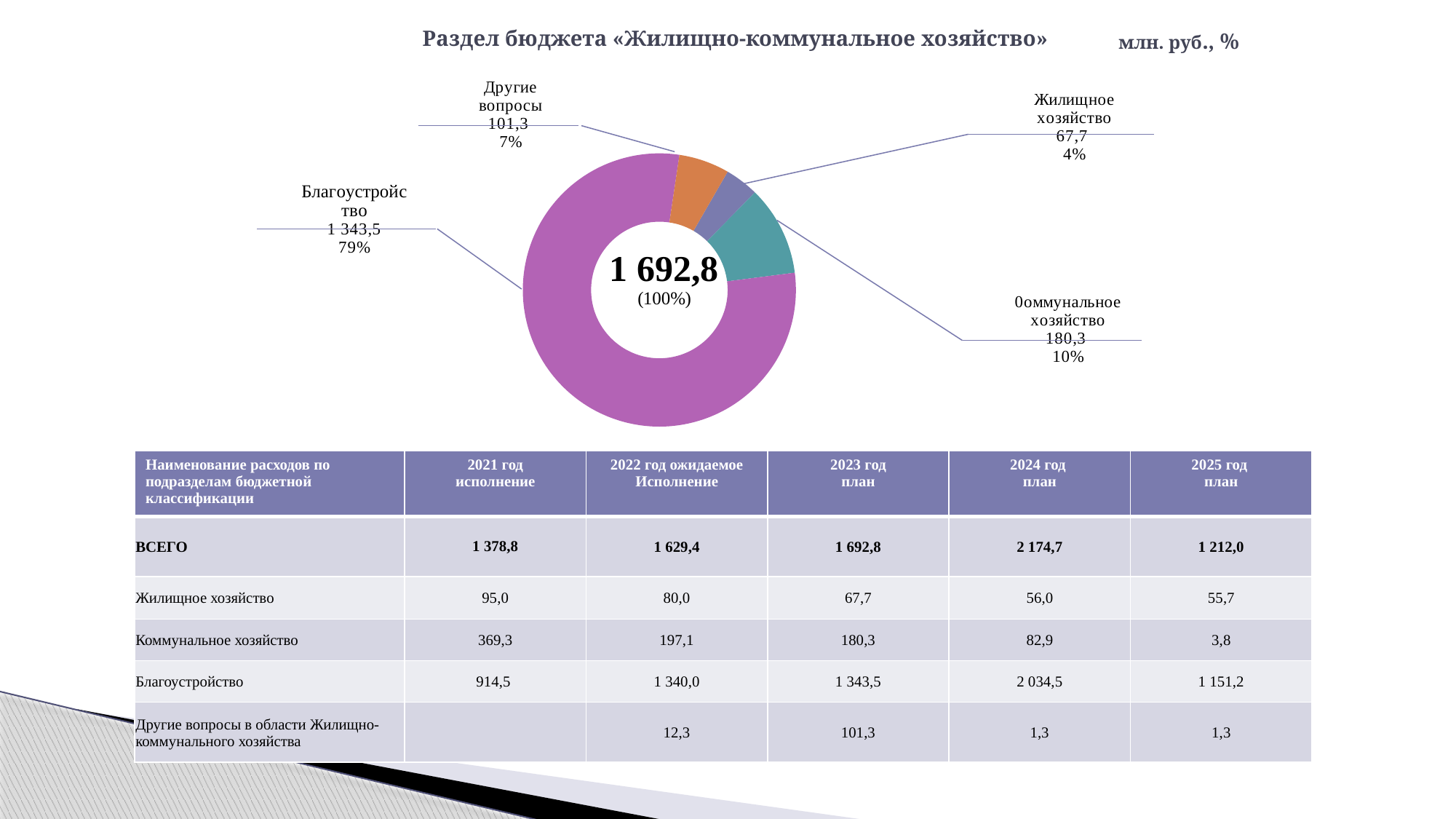
What share of the donut chart does Благоустройство represent? 79% What is the value for Коммунальное хозяйство in the donut chart? 180,3 How many slices does the donut chart have? 4 What kind of chart is shown on the slide? Donut (pie) chart Which category has the largest slice in the donut chart? Благоустройство What is the value for Благоустройство in the donut chart? 1 343,5 What is the difference between the values for Коммунальное хозяйство and Другие вопросы in the donut chart? 79,0 Which category has the smallest slice in the donut chart? Жилищное хозяйство Which is larger in the donut chart: Коммунальное хозяйство or Жилищное хозяйство? Коммунальное хозяйство What total value is shown in the centre of the donut chart? 1 692,8 What is the value for Жилищное хозяйство in the donut chart? 67,7 What share of the donut chart does Другие вопросы represent? 7%